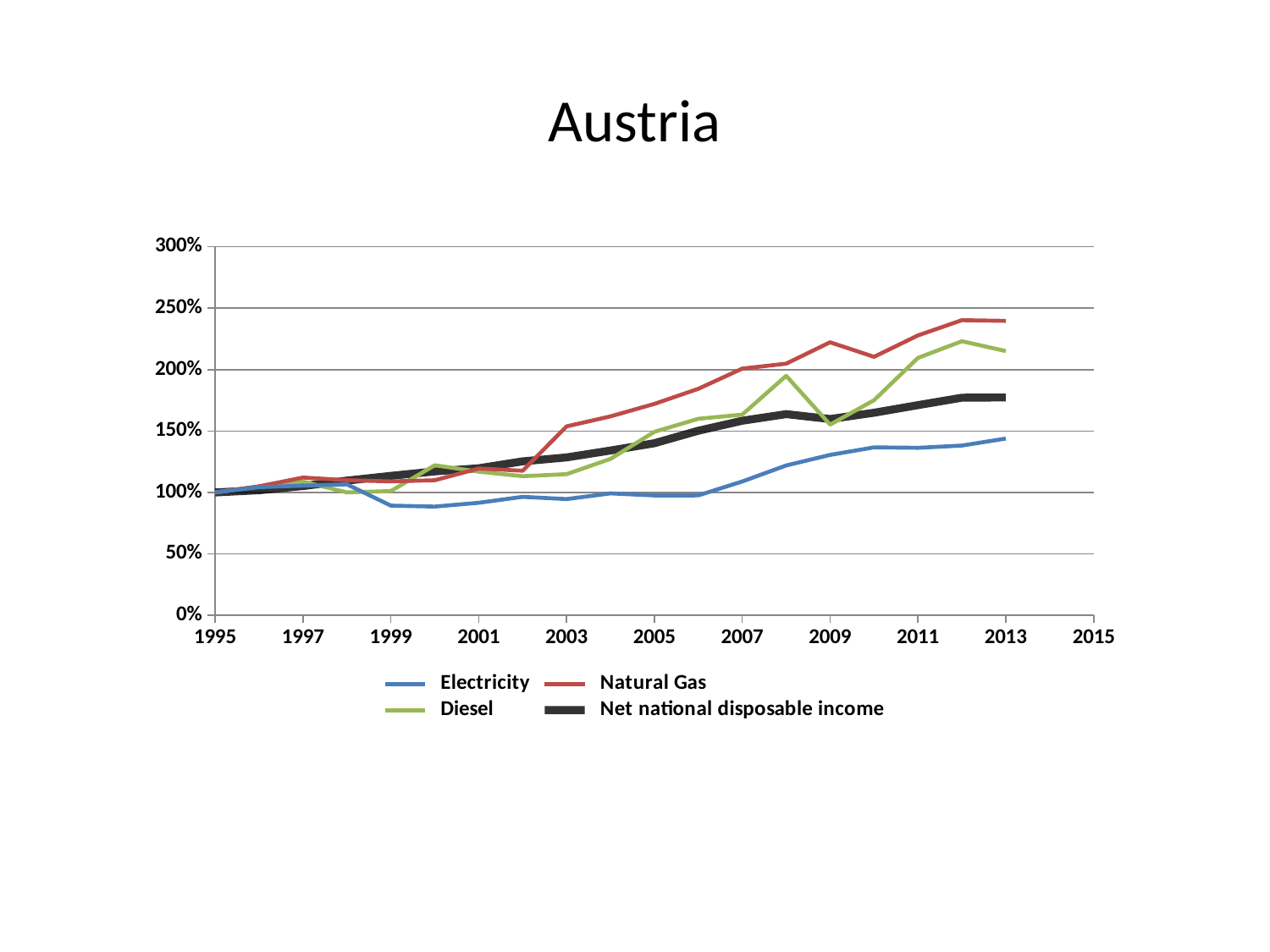
Is the value for Net national disposable income in 2013 greater or less than 200%? less How many series does the legend list? 4 In 2013, which is larger: the value for Diesel or the value for Electricity? Diesel Is the value for Natural Gas in 2013 greater or less than 200%? greater Which series has the highest value in 2013? Natural Gas Is the value for Electricity in 2013 greater or less than 150%? less Which series has the lowest value in 2013? Electricity Which series is drawn with the thick black line? Net national disposable income Does the Natural Gas line rise or fall overall from 1995 to 2013? rise What is the title of the chart? Austria What kind of chart is shown on the slide? line chart